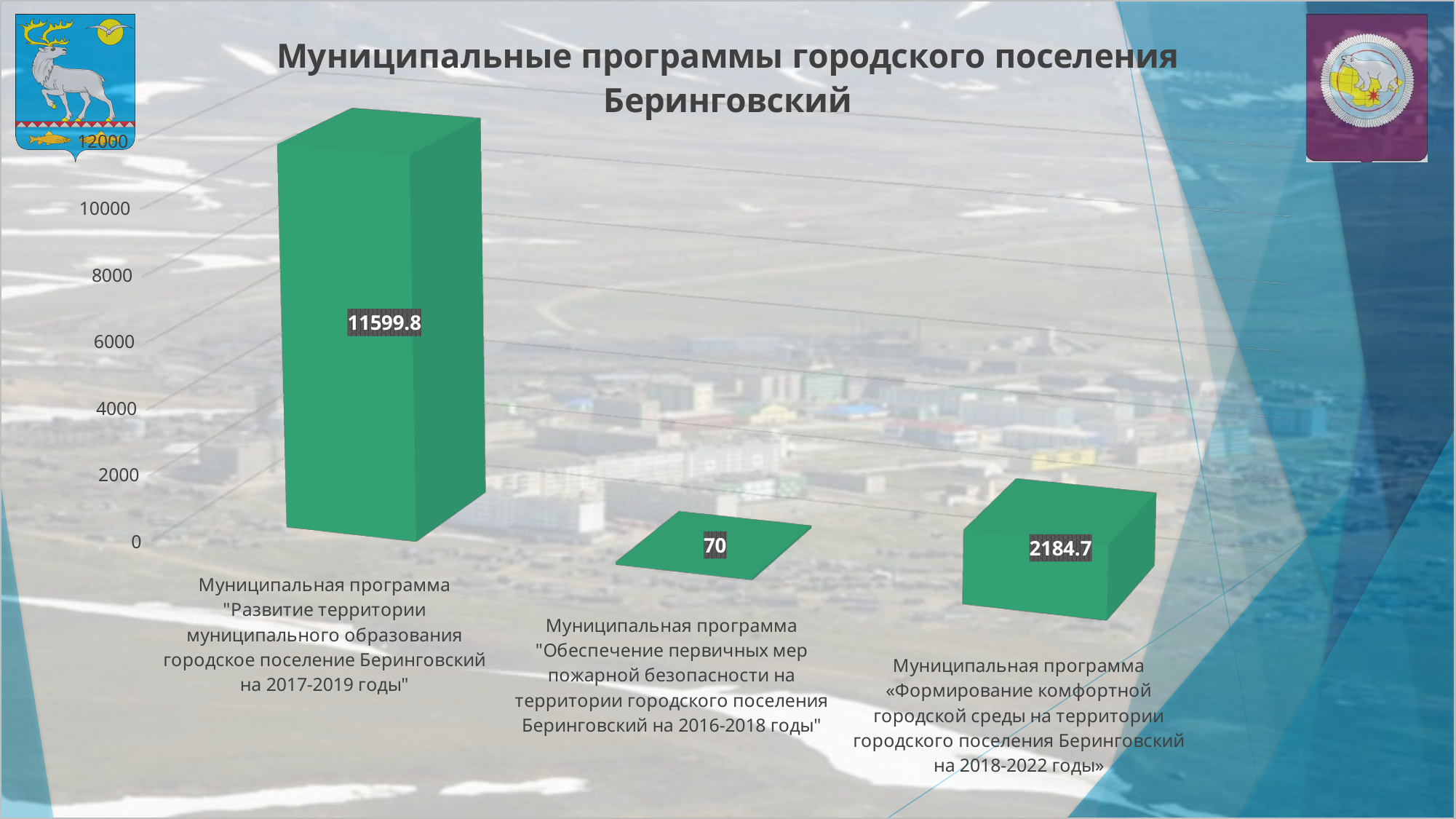
What is the difference between the value for the "Формирование комфортной городской среды" program and the "Обеспечение первичных мер пожарной безопасности" program? 2114.7 What is the value for the municipal program "Обеспечение первичных мер пожарной безопасности на территории городского поселения Беринговский на 2016-2018 годы"? 70 What is the value for the municipal program "Развитие территории муниципального образования городское поселение Беринговский на 2017-2019 годы"? 11599.8 What is the difference between the value for the "Развитие территории" program and the "Формирование комфортной городской среды" program? 9415.1 Which is larger: the value for the "Формирование комфортной городской среды" program or the "Обеспечение первичных мер пожарной безопасности" program? Формирование комфортной городской среды What is the title of the slide? Муниципальные программы городского поселения Беринговский Which municipal program has the lowest value? Обеспечение первичных мер пожарной безопасности на территории городского поселения Беринговский на 2016-2018 годы Which municipal program has the highest value? Развитие территории муниципального образования городское поселение Беринговский на 2017-2019 годы Is the value for the "Развитие территории" program greater or less than 10000? greater What is the value for the municipal program «Формирование комфортной городской среды на территории городского поселения Беринговский на 2018-2022 годы»? 2184.7 What kind of chart is shown on the slide? bar chart How many municipal programs are shown in the chart? 3